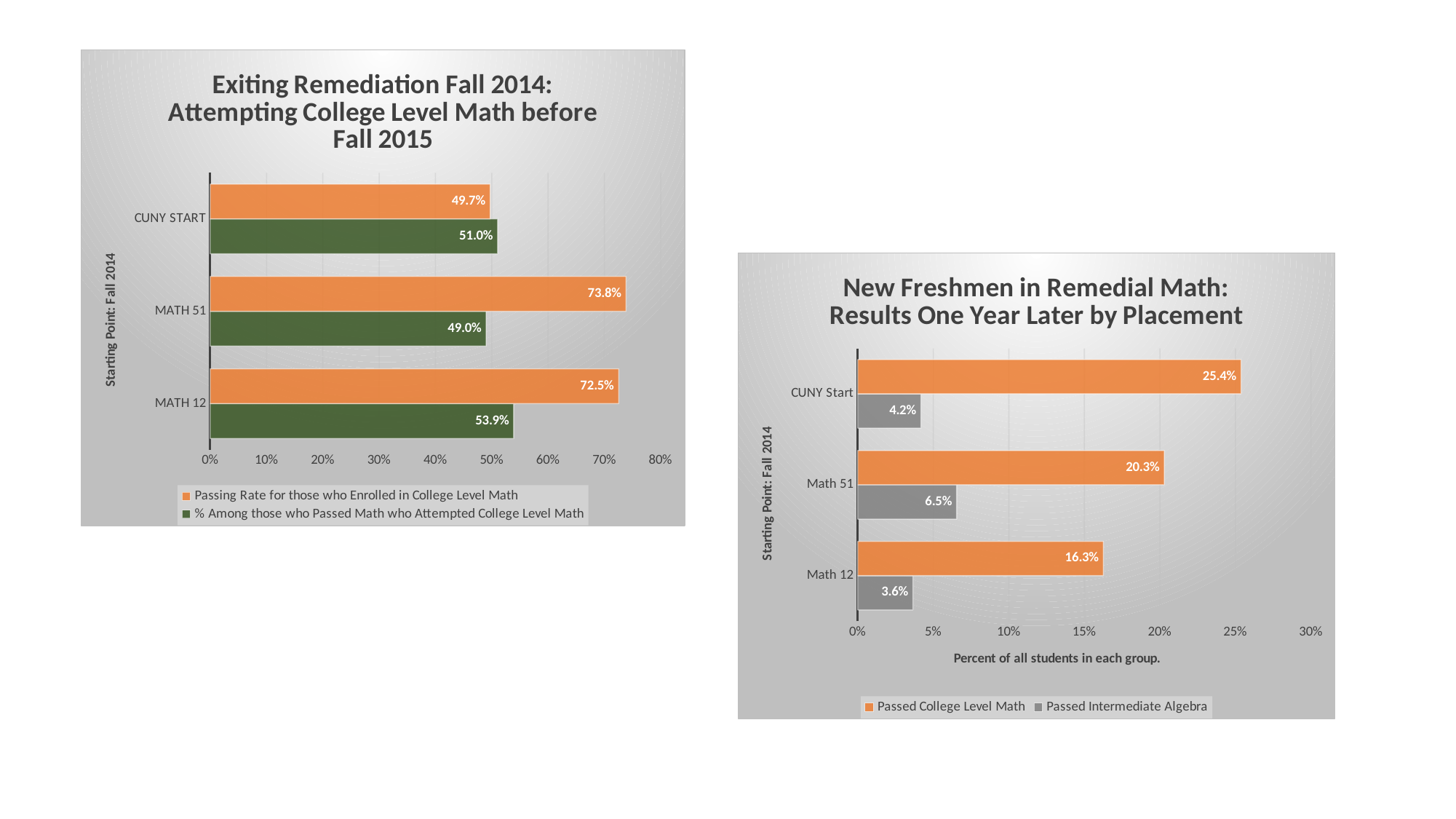
In the 'New Freshmen in Remedial Math' chart, what percent of CUNY Start students Passed Intermediate Algebra? 4.2% In the 'Exiting Remediation Fall 2014' chart, which is larger for CUNY START: the Passing Rate for those who Enrolled in College Level Math or the % Among those who Passed Math who Attempted College Level Math? % Among those who Passed Math who Attempted College Level Math In the 'Exiting Remediation Fall 2014' chart, what is the difference between the Passing Rate for MATH 51 and the Passing Rate for CUNY START? 24.1% In the 'Exiting Remediation Fall 2014' chart, which starting point has the lowest Passing Rate for those who Enrolled in College Level Math? CUNY START In the 'Exiting Remediation Fall 2014' chart, what is the % Among those who Passed Math who Attempted College Level Math for MATH 12? 53.9% In the 'New Freshmen in Remedial Math' chart, which placement group has the highest percent who Passed College Level Math? CUNY Start What kind of chart is the 'New Freshmen in Remedial Math' chart? Bar chart In the 'New Freshmen in Remedial Math' chart, what percent of Math 51 students Passed College Level Math? 20.3% In the 'New Freshmen in Remedial Math' chart, what is the difference between the Passed College Level Math and Passed Intermediate Algebra values for Math 12? 12.7% In the 'Exiting Remediation Fall 2014' chart, how many series does the legend list? 2 In the 'Exiting Remediation Fall 2014' chart, what is the Passing Rate for those who Enrolled in College Level Math for MATH 51? 73.8% In the 'New Freshmen in Remedial Math' chart, how many placement groups are shown? 3